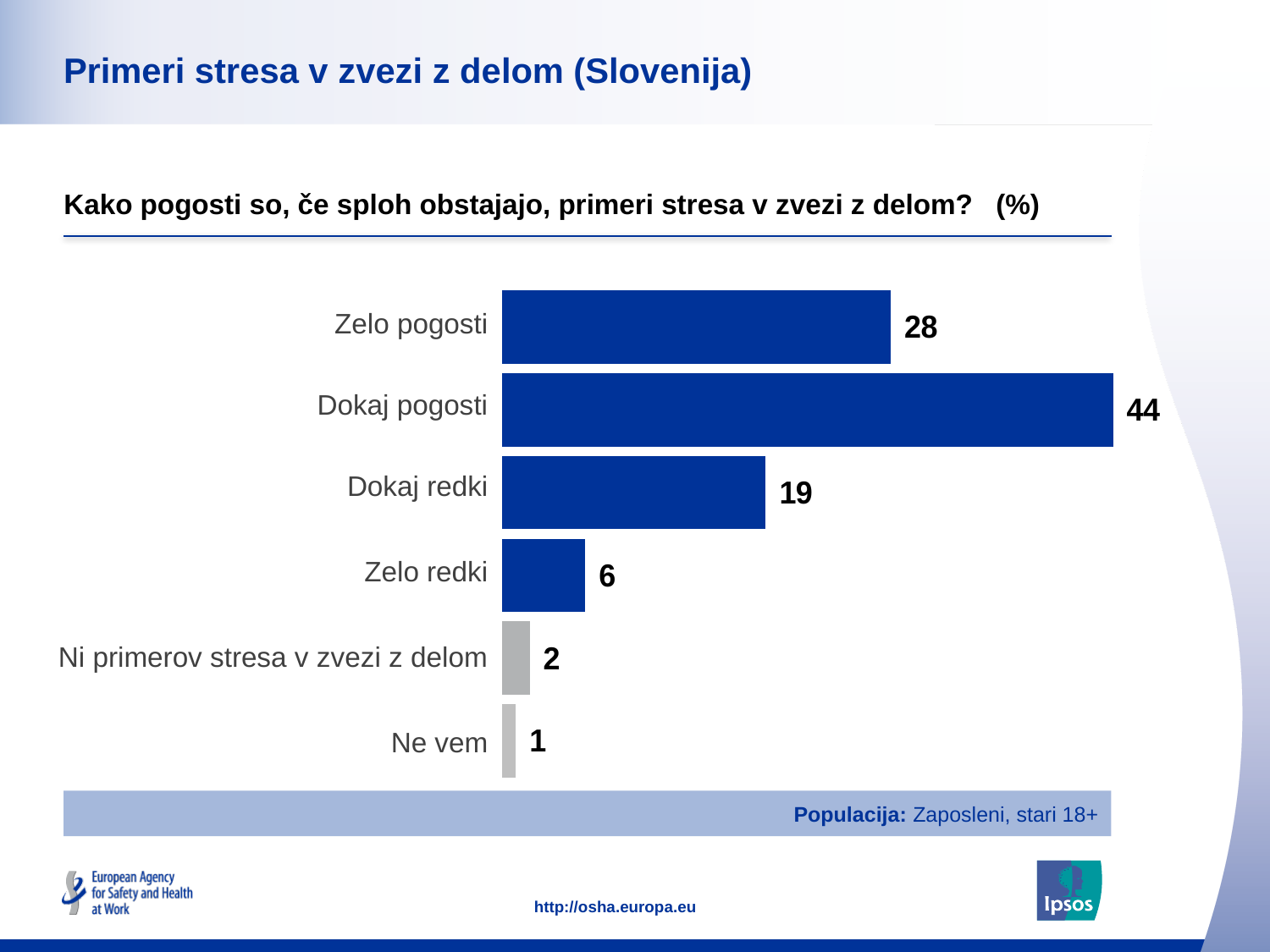
What kind of chart is shown on the slide? Bar chart What is the value for "Zelo redki"? 6 What is the difference between the values for "Dokaj pogosti" and "Zelo pogosti"? 16 What is the value for "Dokaj pogosti"? 44 What is the value for "Ni primerov stresa v zvezi z delom"? 2 How many categories are shown in the chart? 6 Which is larger, the value for "Zelo pogosti" or the value for "Dokaj redki"? Zelo pogosti Which category has the lowest value? Ne vem Which categories are shown with grey bars instead of blue? Ni primerov stresa v zvezi z delom and Ne vem Which category has the highest value? Dokaj pogosti What is the difference between the values for "Dokaj redki" and "Zelo redki"? 13 What is the title of the slide? Primeri stresa v zvezi z delom (Slovenija)